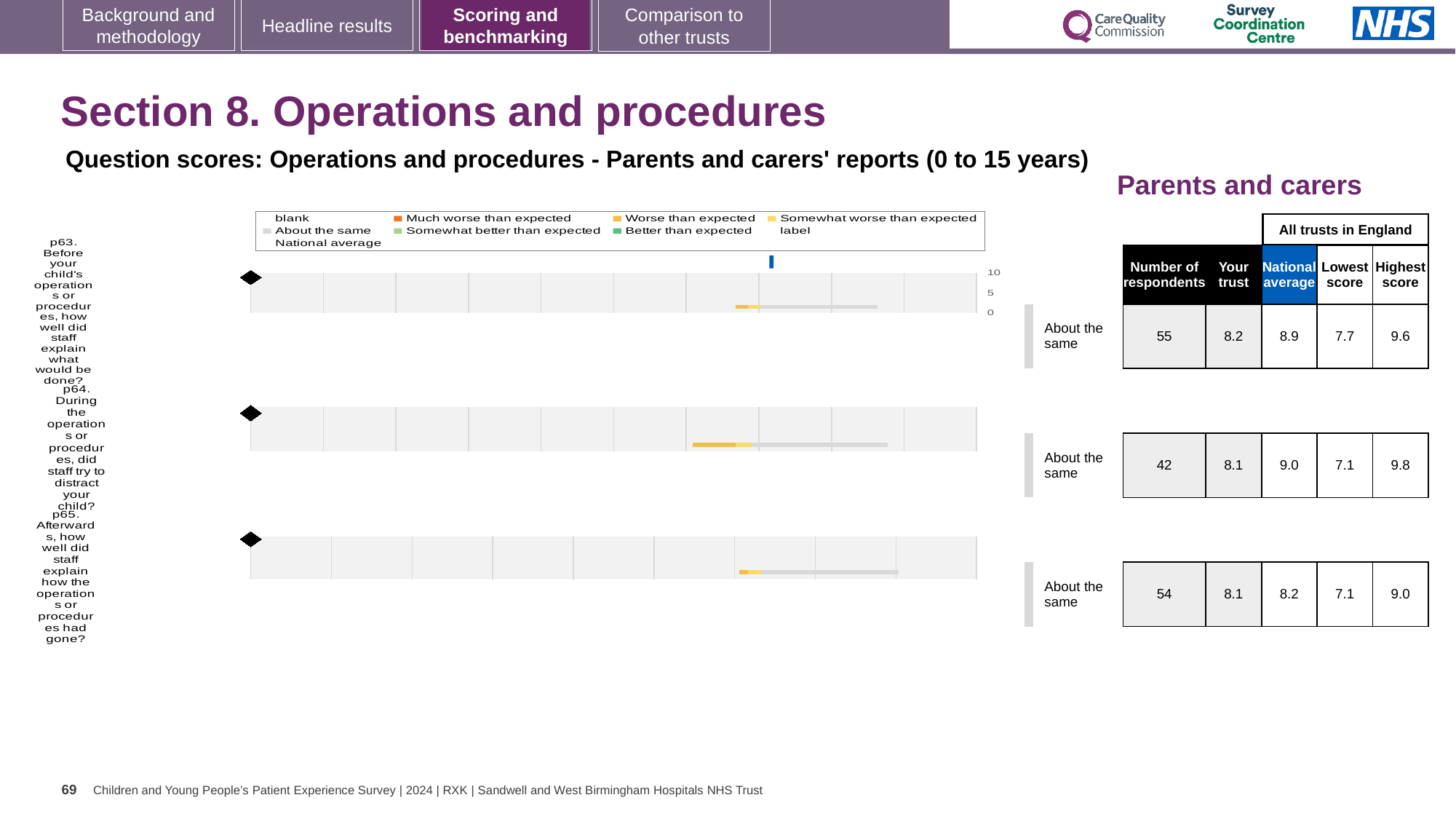
How many questions are plotted on the chart? 3 How many respondents are shown for question p63 (Before your child's operations or procedures, how well did staff explain what would be done?)? 55 What benchmarking category is shown for all three questions on the slide? About the same Which question has the highest number of respondents? p63 What is the lowest score across all trusts in England for question p63? 7.7 What kind of chart is used to show the question scores? Bar chart What is the national average score for question p65 (Afterwards, how well did staff explain how the operations or procedures had gone?)? 8.2 Which question has the lowest national average score? p65 What is the 'Your trust' score for question p64 (During the operations or procedures, did staff try to distract your child?)? 8.1 For question p63, what is the difference between the national average and the 'Your trust' score? 0.7 Is the 'Your trust' score higher for question p63 or question p64? p63 What is the highest score across all trusts in England for question p64? 9.8